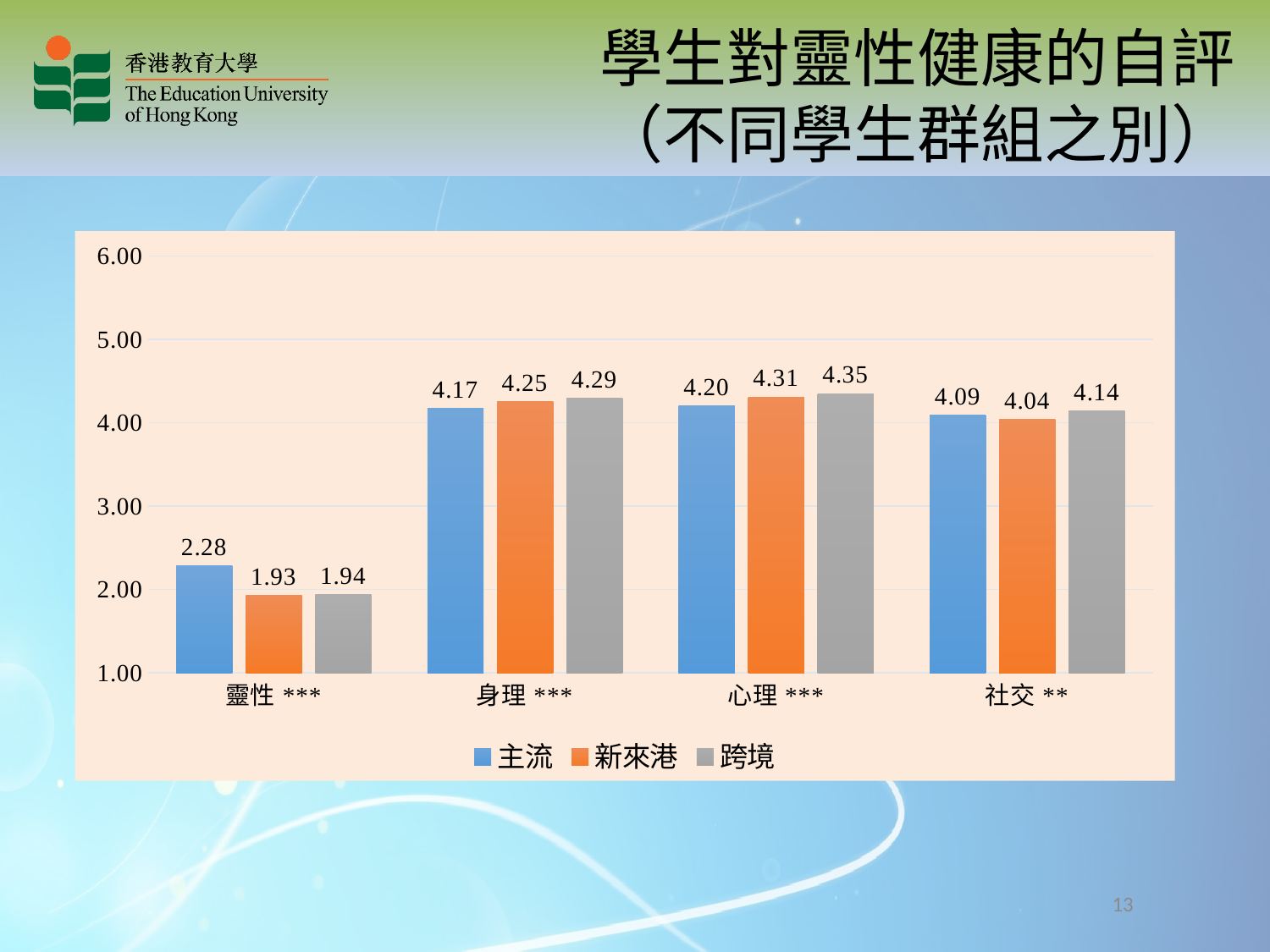
How many categories are shown on the x axis? 4 Is the value for 跨境 in the 靈性 *** category greater or less than 3.00? less What is the difference between the 主流 and 新來港 values in the 靈性 *** category? 0.35 How many series does the legend list? 3 What colour represents the 新來港 series in the legend? orange What is the value for 跨境 in the 心理 *** category? 4.35 Which series has the highest value in the 身理 *** category? 跨境 What kind of chart is shown on the slide? bar chart What is the value for 新來港 in the 社交 ** category? 4.04 Which is larger in the 社交 ** category: the value for 主流 or the value for 新來港? 主流 What is the value for 主流 in the 靈性 *** category? 2.28 Which category has the lowest value for the 主流 series? 靈性 ***